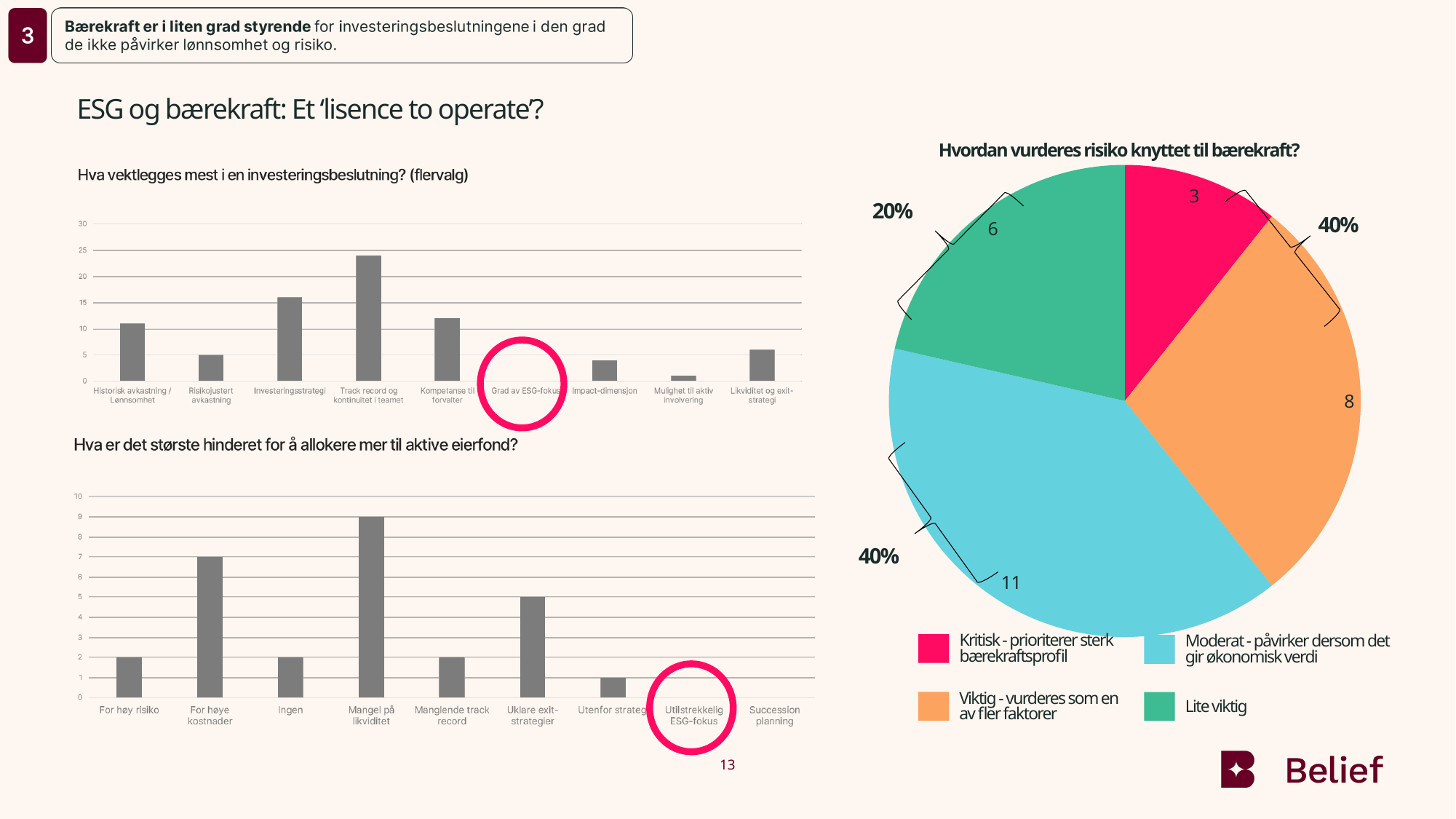
In the pie chart 'Hvordan vurderes risiko knyttet til bærekraft?', which category has the smallest slice? Kritisk - prioriterer sterk bærekraftsprofil How many categories are shown on the x axis of the chart 'Hva vektlegges mest i en investeringsbeslutning? (flervalg)'? 9 In the chart 'Hva vektlegges mest i en investeringsbeslutning? (flervalg)', is the value for 'Investeringsstrategi' greater or less than 15? greater What kind of chart is 'Hva er det største hinderet for å allokere mer til aktive eierfond?'? bar chart In the chart 'Hva er det største hinderet for å allokere mer til aktive eierfond?', which category has the highest value? Mangel på likviditet In the chart 'Hva er det største hinderet for å allokere mer til aktive eierfond?', what is the difference between 'Mangel på likviditet' and 'Uklare exit-strategier'? 4 In the chart 'Hva er det største hinderet for å allokere mer til aktive eierfond?', what is the value for 'For høye kostnader'? 7 In the chart 'Hva vektlegges mest i en investeringsbeslutning? (flervalg)', which is larger: 'Historisk avkastning / Lønnsomhet' or 'Impact-dimensjon'? Historisk avkastning / Lønnsomhet In the chart 'Hva vektlegges mest i en investeringsbeslutning? (flervalg)', which category has the highest value? Track record og kontinuitet i teamet In the pie chart 'Hvordan vurderes risiko knyttet til bærekraft?', what is the value for 'Moderat - påvirker dersom det gir økonomisk verdi'? 11 How many entries does the legend of the pie chart 'Hvordan vurderes risiko knyttet til bærekraft?' list? 4 In the chart 'Hva er det største hinderet for å allokere mer til aktive eierfond?', what is the value for 'Mangel på likviditet'? 9